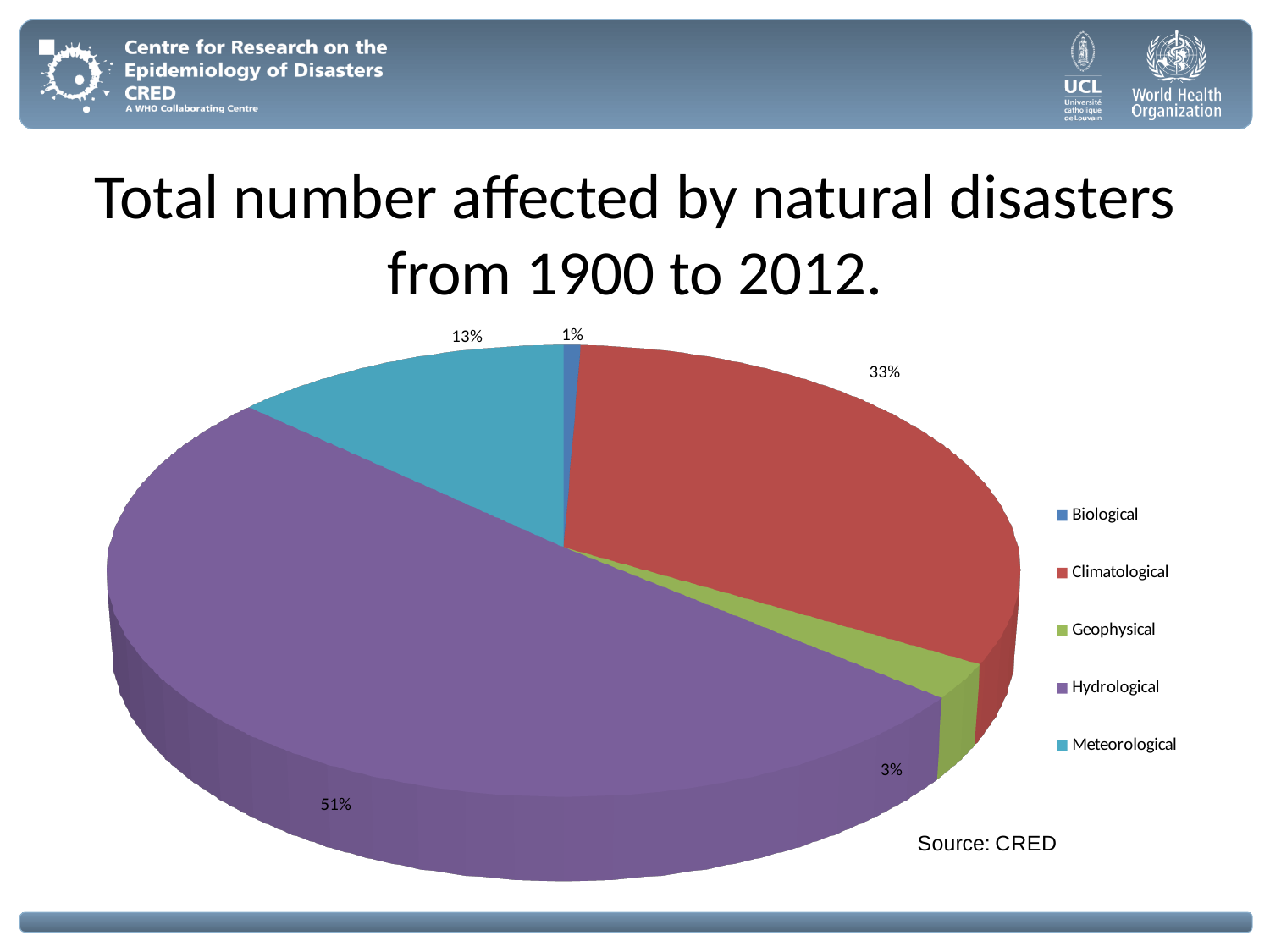
Which has a larger share, Meteorological or Geophysical? Meteorological Which disaster category has the largest share of the total number affected? Hydrological What share of the pie is Biological? 1% How many categories does the legend list? 5 What share of the pie is Climatological? 33% What share of the total number affected by natural disasters is Hydrological? 51% What is the title of the chart? Total number affected by natural disasters from 1900 to 2012. What kind of chart is shown on the slide? Pie chart Which disaster category has the smallest share of the total number affected? Biological How many percentage points larger is the Hydrological share than the Climatological share? 18